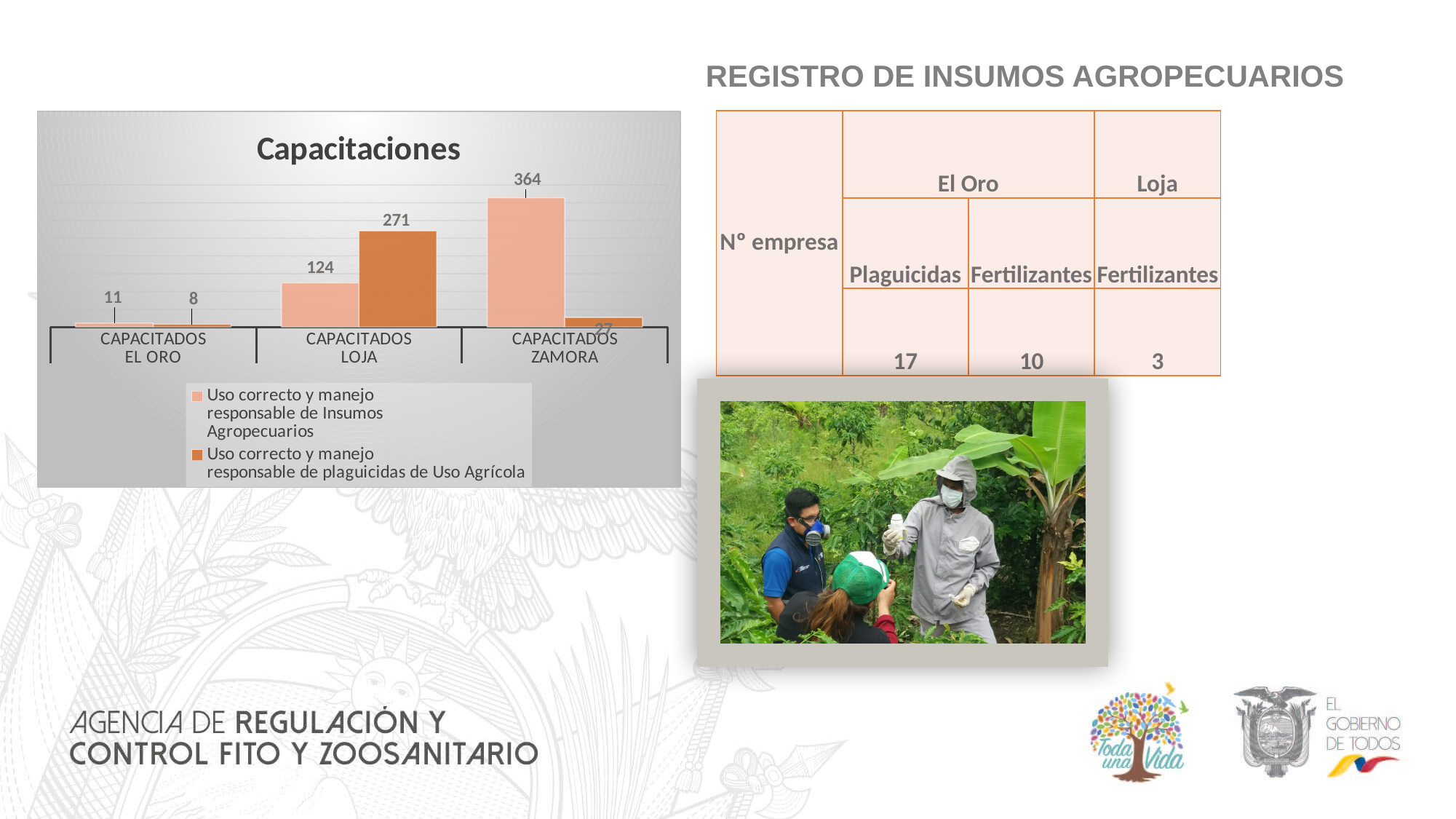
For CAPACITADOS LOJA, which series has the larger value? Uso correcto y manejo responsable de plaguicidas de Uso Agrícola How many series does the legend of the Capacitaciones chart list? 2 What is the value for CAPACITADOS LOJA in the 'Uso correcto y manejo responsable de plaguicidas de Uso Agrícola' series? 271 What is the difference between the two series values for CAPACITADOS LOJA? 147 What is the value for CAPACITADOS EL ORO in the 'Uso correcto y manejo responsable de plaguicidas de Uso Agrícola' series? 8 What is the value for CAPACITADOS ZAMORA in the 'Uso correcto y manejo responsable de Insumos Agropecuarios' series? 364 What is the value for CAPACITADOS EL ORO in the 'Uso correcto y manejo responsable de Insumos Agropecuarios' series? 11 What type of chart is the Capacitaciones chart? Bar chart How many categories are shown on the x axis of the Capacitaciones chart? 3 What is the difference between the 'Insumos Agropecuarios' values for CAPACITADOS ZAMORA and CAPACITADOS LOJA? 240 Which category has the lowest value in the 'Uso correcto y manejo responsable de plaguicidas de Uso Agrícola' series? CAPACITADOS EL ORO Which category has the highest value in the 'Uso correcto y manejo responsable de Insumos Agropecuarios' series? CAPACITADOS ZAMORA